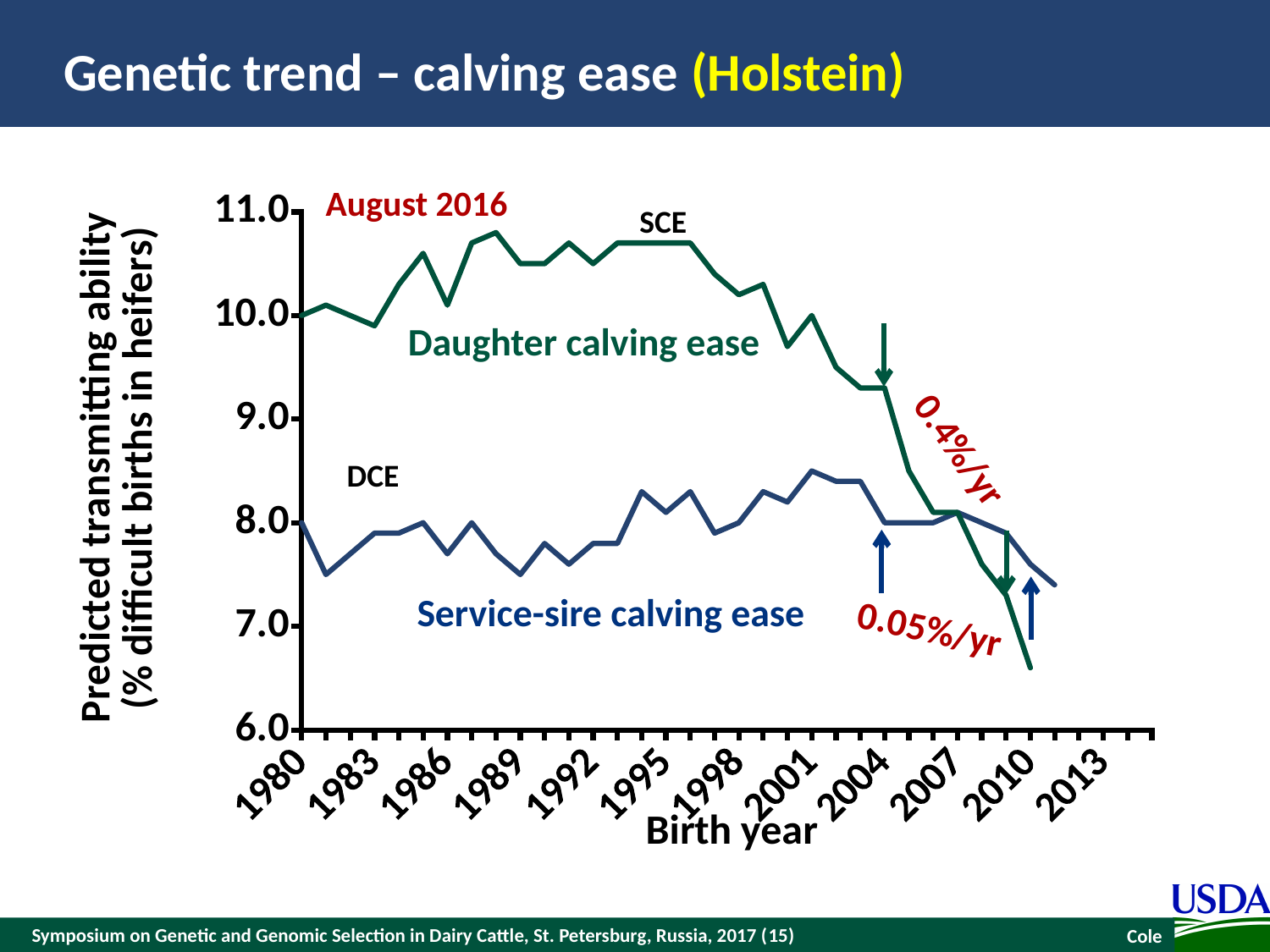
Is the Service-sire calving ease value for 1989 greater or less than 8.0? less Does the Daughter calving ease line rise or fall overall from 1980 to the end of the series? Fall Is the Service-sire calving ease value for 2001 greater or less than 8.0? greater In 1995, which line is higher: Daughter calving ease or Service-sire calving ease? Daughter calving ease What is the label of the x axis? Birth year What kind of chart is shown on the slide? Line chart Is the Daughter calving ease value for 1989 greater or less than 10.0? greater Does the Service-sire calving ease line rise or fall between 2004 and the end of the series? Fall How many lines are plotted on the chart? 2 In 2010, which line is higher: Daughter calving ease or Service-sire calving ease? Service-sire calving ease What annual rate of change is annotated for the Daughter calving ease line? 0.4%/yr